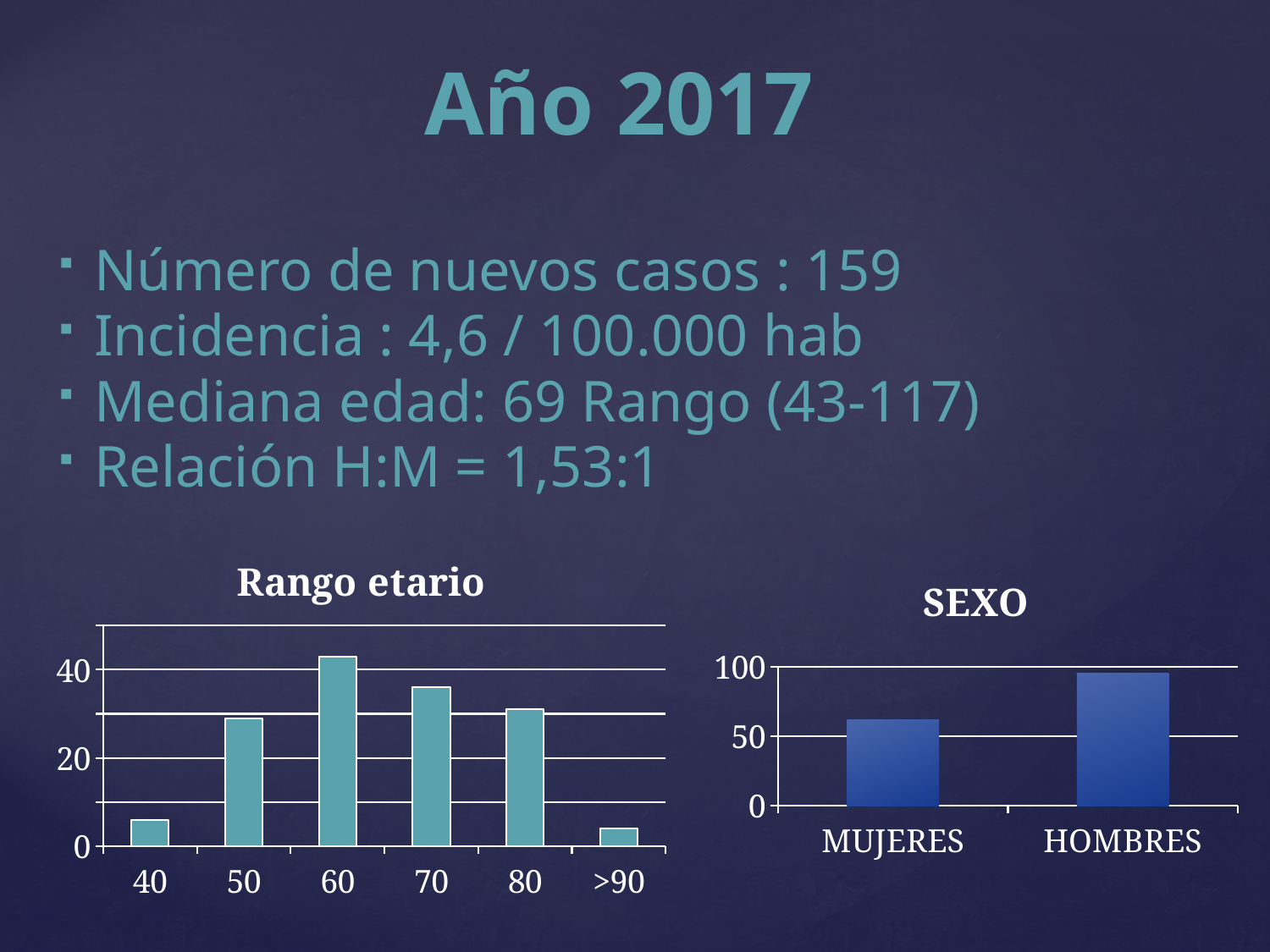
In the "Rango etario" chart, which category has the lowest bar? >90 In the "Rango etario" chart, is the value for 40 greater or less than 20? less In the "Rango etario" chart, which category has the highest bar? 60 What is the title of the chart on the right side of the slide? SEXO How many categories are shown on the x axis of the "Rango etario" chart? 6 In the "Rango etario" chart, do the values rise or fall from 60 to >90? fall In the "Rango etario" chart, which is larger, the value for 70 or the value for 80? 70 What kind of chart is the "SEXO" chart? bar chart What kind of chart is the "Rango etario" chart? bar chart In the "SEXO" chart, which category has the higher bar? HOMBRES In the "SEXO" chart, is the value for MUJERES greater or less than 50? greater In the "Rango etario" chart, is the value for 60 greater or less than 40? greater